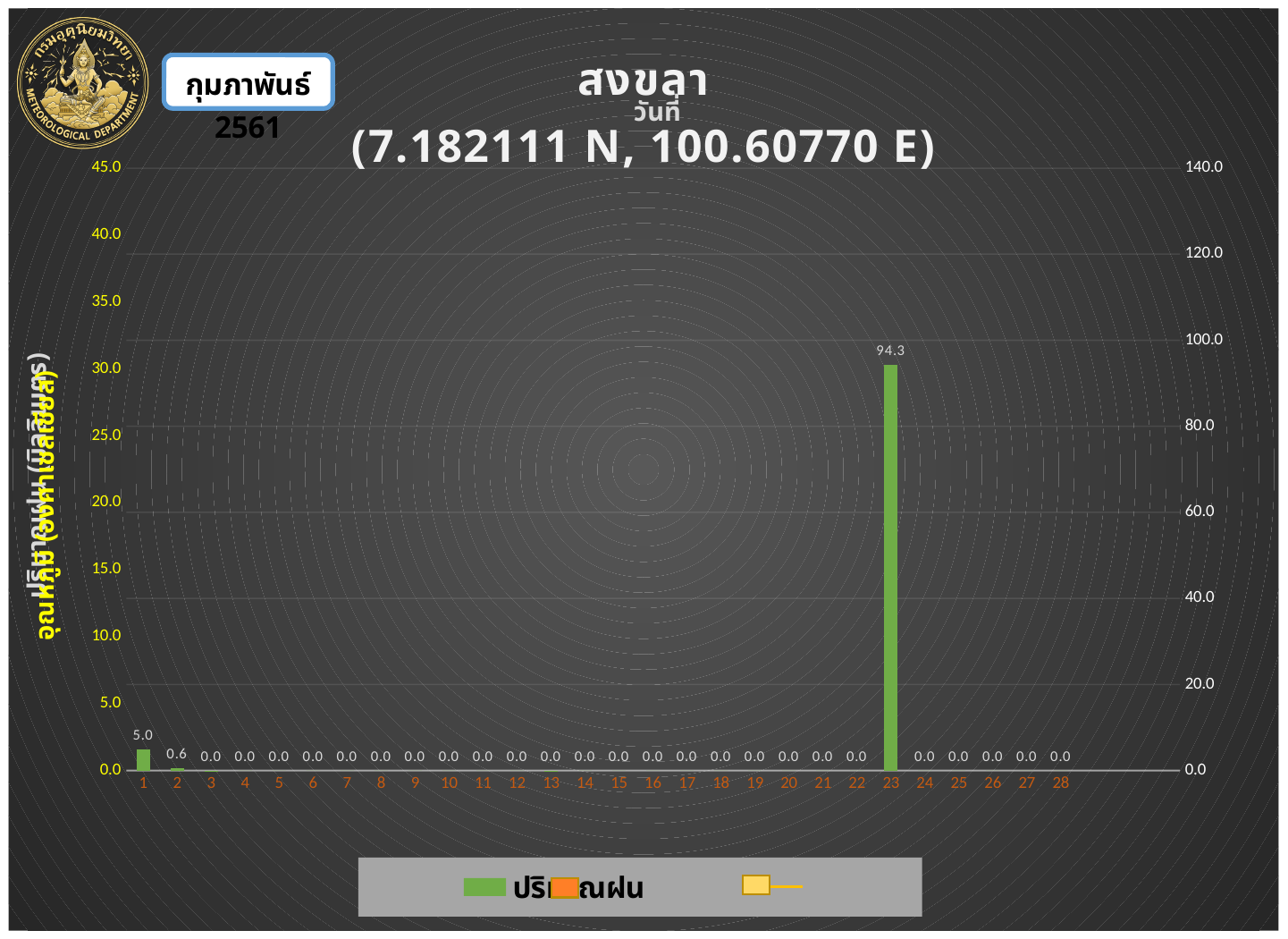
How many days are shown on the x axis? 28 What kind of chart is shown on the slide? bar chart What is the rainfall value shown for day 2? 0.6 What is the rainfall value shown for day 23? 94.3 What is the difference between the rainfall values for day 23 and day 1? 89.3 What is the difference between the rainfall values for day 1 and day 2? 4.4 What coordinates are given in the chart title? 7.182111 N, 100.60770 E Which day has the highest rainfall value? 23 What is the rainfall value shown for day 15? 0.0 Which has the larger rainfall value, day 1 or day 2? day 1 What is the rainfall value shown for day 1? 5.0 Is the value for day 23 on the right-hand axis greater or less than 80.0? greater